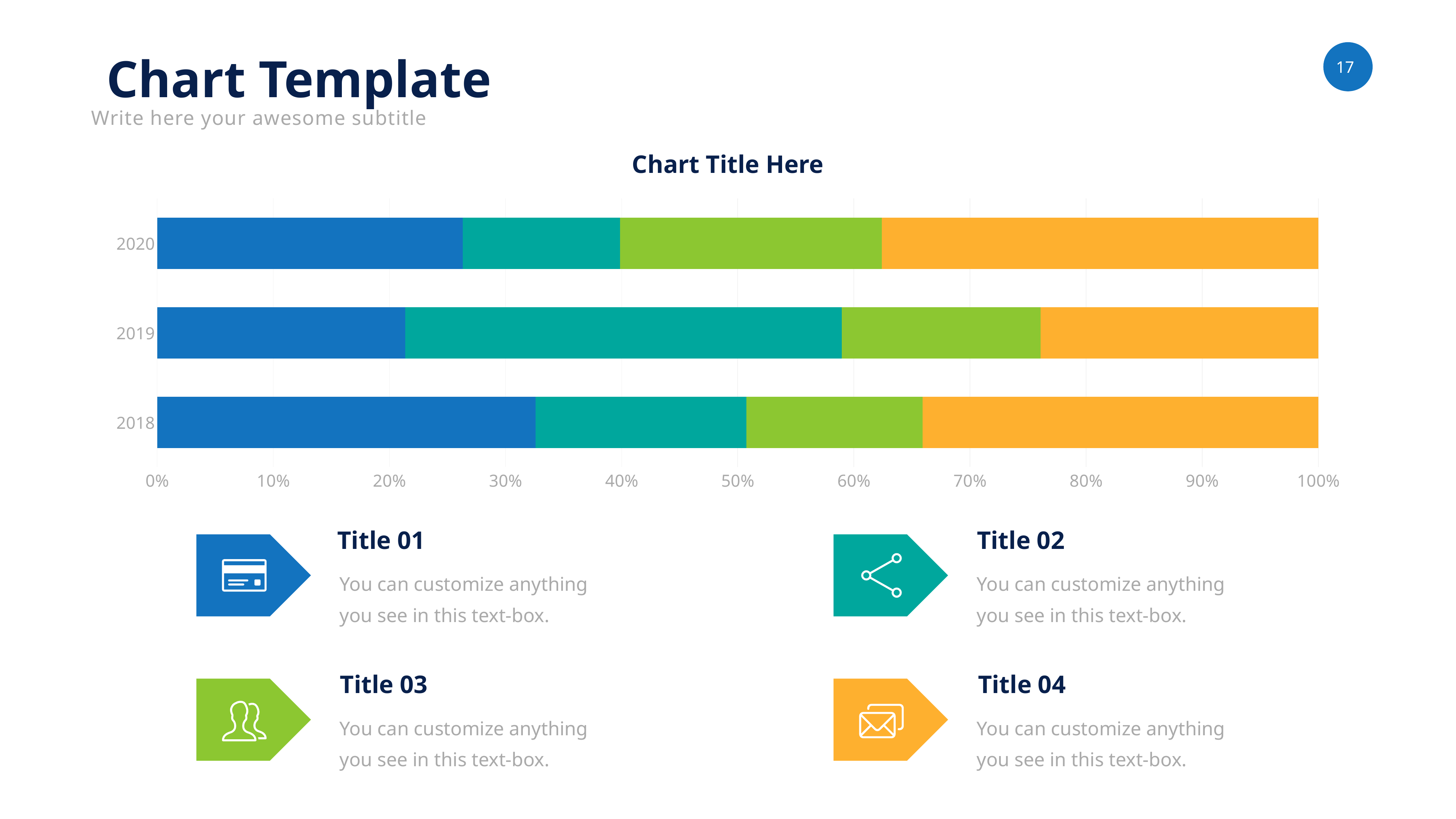
How many categories (years) are shown on the chart's vertical axis? 3 Which year has the smallest blue (first) segment? 2019 Which year has the largest blue (first) segment? 2018 Which year has the largest teal (second) segment? 2019 What kind of chart is shown on the slide? Stacked bar chart What is the highest value shown on the horizontal axis? 100% Is the blue segment for 2019 greater or less than 30%? less What value does the 2020 bar reach in total on the horizontal axis? 100% Is the blue segment for 2018 greater or less than 30%? greater What is the title of the chart? Chart Title Here How many coloured segments make up each bar in the chart? 4 Is the blue segment for 2020 greater or less than 30%? less